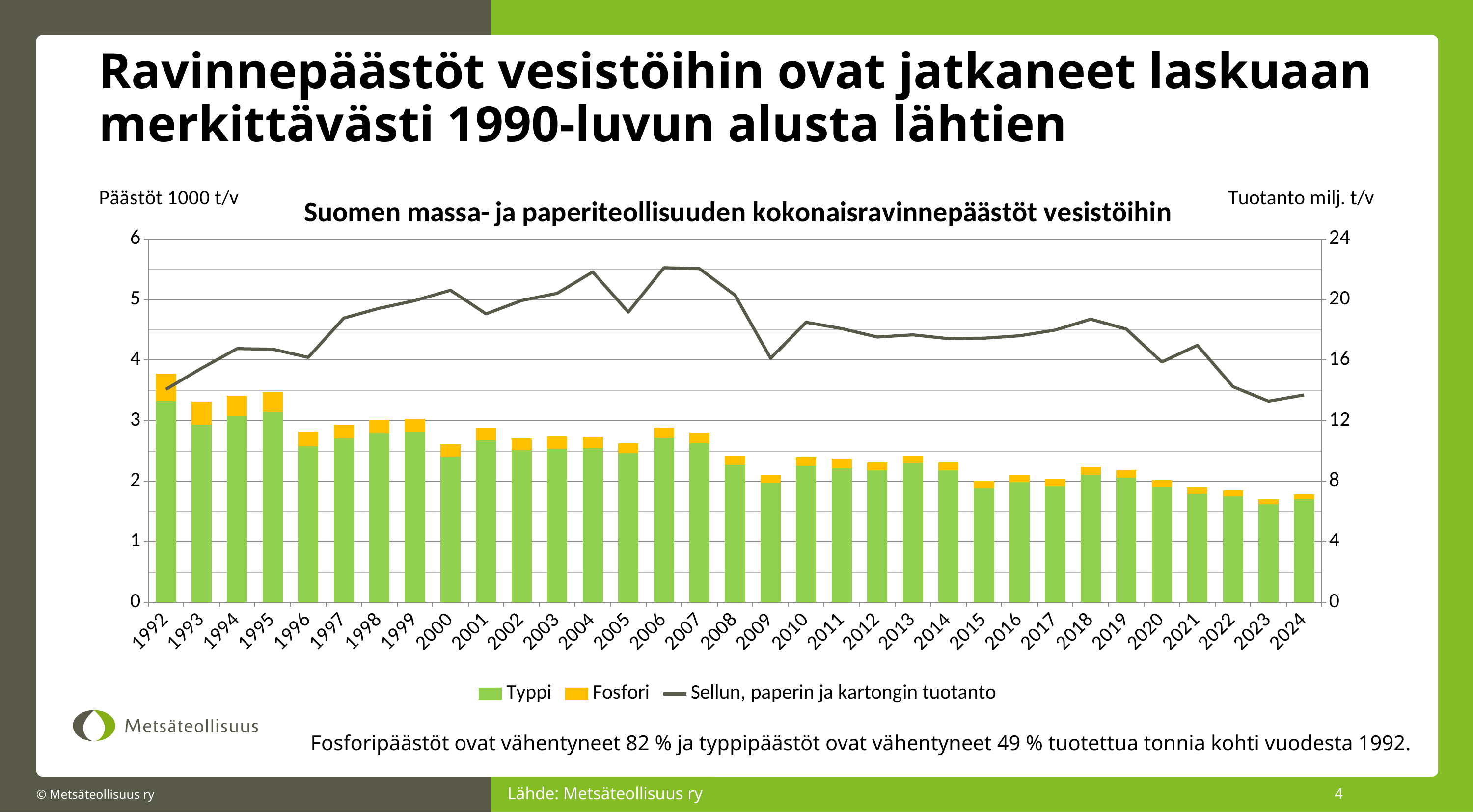
Which is larger, the total emissions bar for 1995 or for 1996? 1995 Do the total emissions bars generally rise or fall from 1992 to 2024? fall Is the total emissions bar for 2000 greater or less than 3? less Which year has the highest total emissions bar (Typpi plus Fosfori)? 1992 How many years are shown on the x axis of the chart? 33 Is the total emissions bar for 2023 greater or less than 2? less Is the value of the Sellun, paperin ja kartongin tuotanto line for 2004 greater or less than 20? greater What kind of chart is shown on the slide? Stacked bar chart with a line How many series does the chart legend list? 3 What is the title of the chart? Suomen massa- ja paperiteollisuuden kokonaisravinnepäästöt vesistöihin